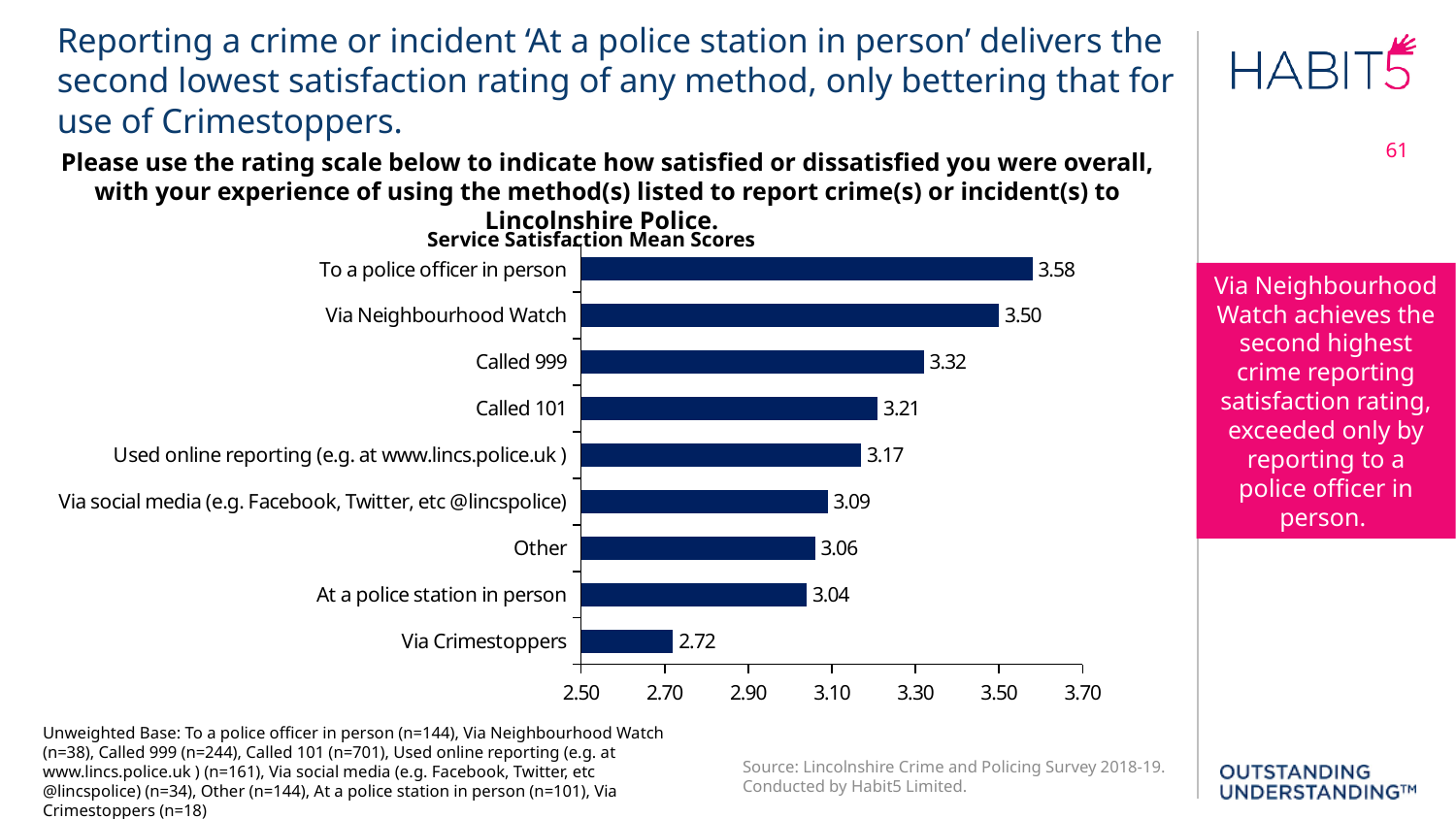
What type of chart is used to show the Service Satisfaction Mean Scores? Bar chart Which has a higher mean satisfaction score, 'Via Neighbourhood Watch' or 'Called 101'? Via Neighbourhood Watch What is the difference between the mean scores for 'Called 999' and 'Called 101'? 0.11 How many reporting methods are shown in the chart? 9 What is the mean satisfaction score for 'Via Crimestoppers'? 2.72 What is the mean satisfaction score for 'At a police station in person'? 3.04 What is the difference between the mean scores for 'To a police officer in person' and 'Via Crimestoppers'? 0.86 Which reporting method has the lowest mean satisfaction score? Via Crimestoppers Which reporting method has the highest mean satisfaction score? To a police officer in person What is the mean satisfaction score for 'Called 999'? 3.32 What is the title of the chart? Service Satisfaction Mean Scores Is the mean score for 'Used online reporting (e.g. at www.lincs.police.uk )' greater or less than 3.10? greater